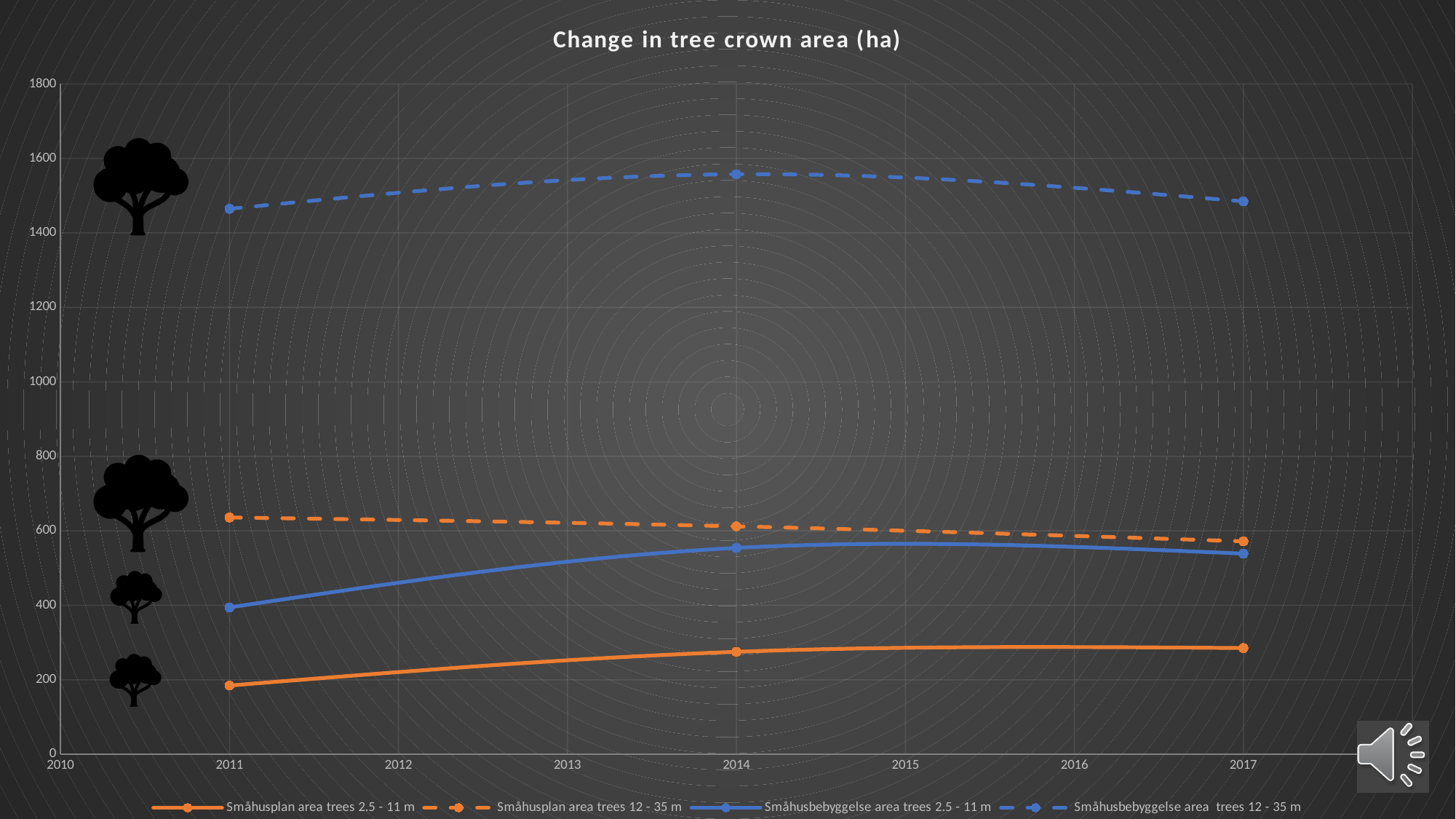
Is the value for Småhusplan area trees 12 - 35 m in 2011 greater or less than 600? greater Which series has the highest values across all years? Småhusbebyggelse area trees 12 - 35 m Is the value for Småhusbebyggelse area trees 12 - 35 m in 2014 greater or less than 1400? greater What kind of chart is shown on the slide? line chart What is the title of the chart? Change in tree crown area (ha) Which series has the lowest values across all years? Småhusplan area trees 2.5 - 11 m In 2011, which is larger: Småhusbebyggelse area trees 2.5 - 11 m or Småhusplan area trees 2.5 - 11 m? Småhusbebyggelse area trees 2.5 - 11 m How many data points are plotted for the Småhusbebyggelse area trees 12 - 35 m series? 3 Does the Småhusplan area trees 12 - 35 m series rise or fall from 2011 to 2017? fall How many series does the legend list? 4